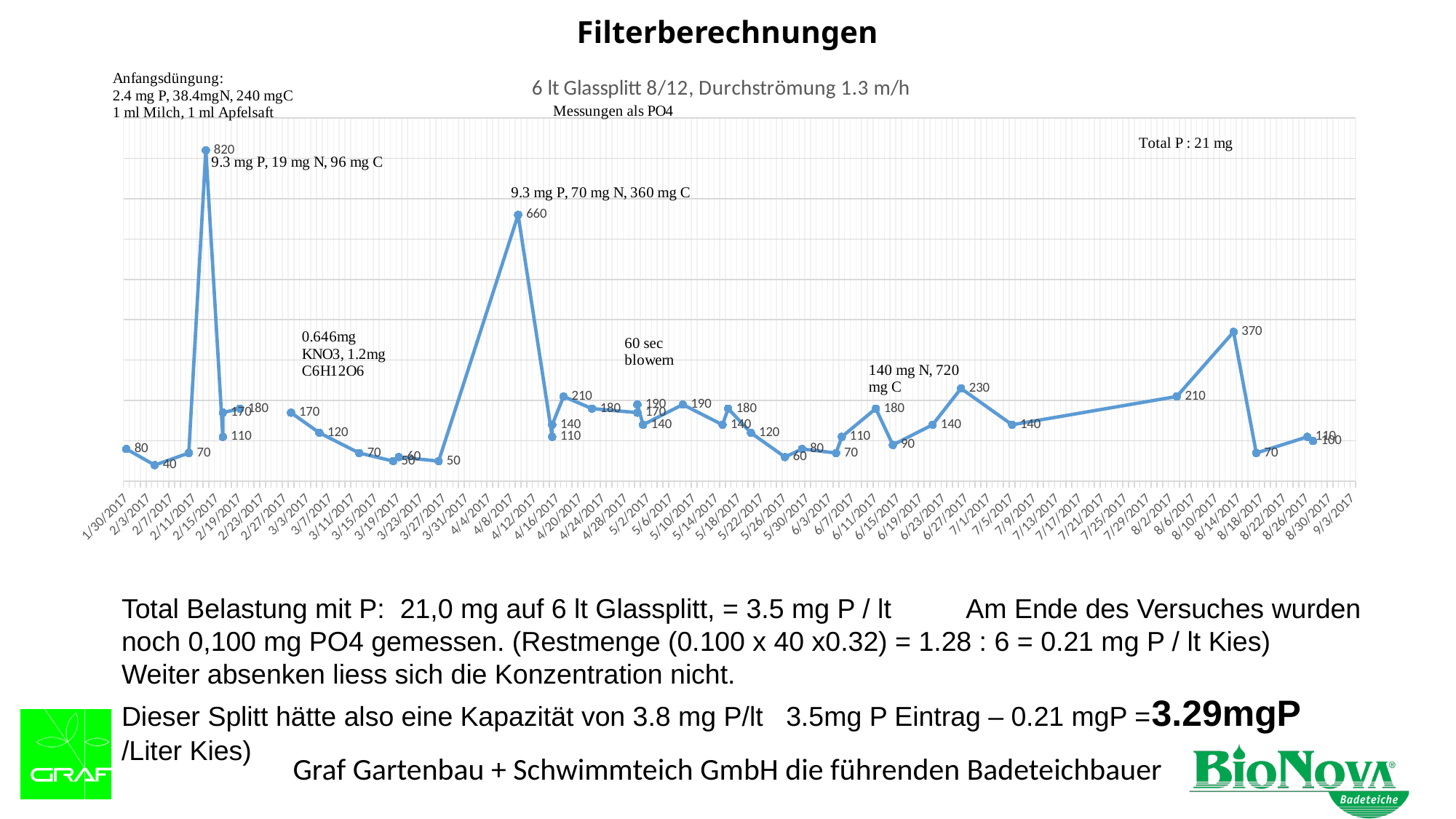
What is the value of the peak in August? 370 What is the difference between the highest peak (820) and the second peak (660)? 160 What is the lowest value labeled on the chart? 40 What is the highest value labeled on the chart? 820 Do the values rise or fall immediately after the 820 peak? fall What kind of chart is shown on the slide? line chart How many data series are plotted on the chart? 1 Which is larger, the peak in mid-February or the peak in early April? the mid-February peak (820) What is the difference between the August peak (370) and the late-June peak (230)? 140 What total P value is noted in the top right of the chart? Total P : 21 mg What is the value of the first data point on the chart? 80 What is the title of the chart? 6 lt Glassplitt 8/12, Durchströmung 1.3 m/h